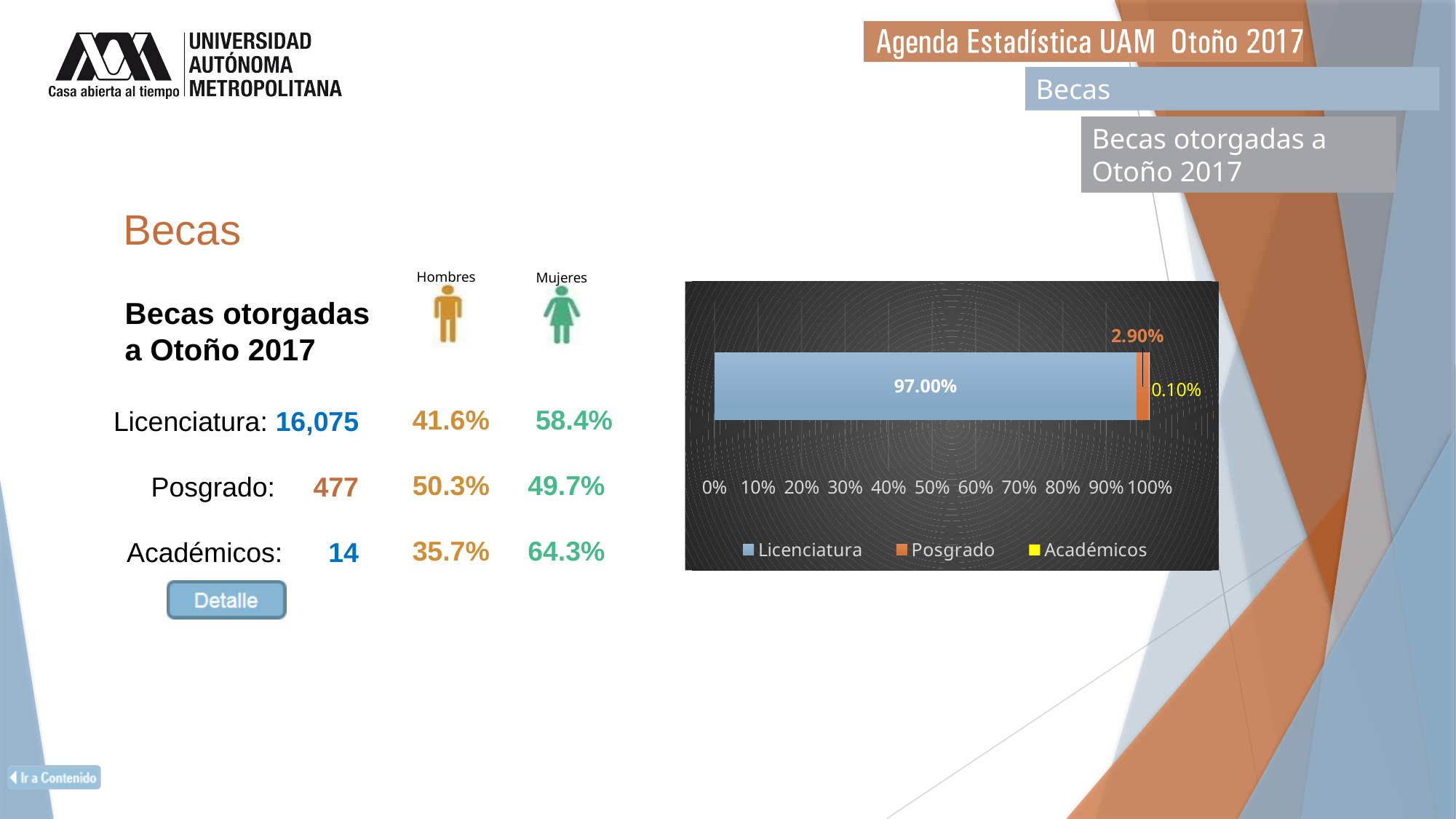
What kind of chart is shown on the slide? bar chart Is the value for Licenciatura in the chart greater or less than 90%? greater Which legend entry in the chart is shown in yellow? Académicos What is the value shown for Académicos in the chart? 0.10% Which series has the lowest value in the chart? Académicos Which series has the highest value in the chart? Licenciatura What is the difference between the Licenciatura and Posgrado values in the chart? 94.10% What is the value shown for Posgrado in the chart? 2.90% How many series does the chart legend list? 3 What is the value shown for Licenciatura in the chart? 97.00% What is the total of the stacked bar in the chart? 100.00% Which is larger in the chart, the value for Posgrado or the value for Académicos? Posgrado